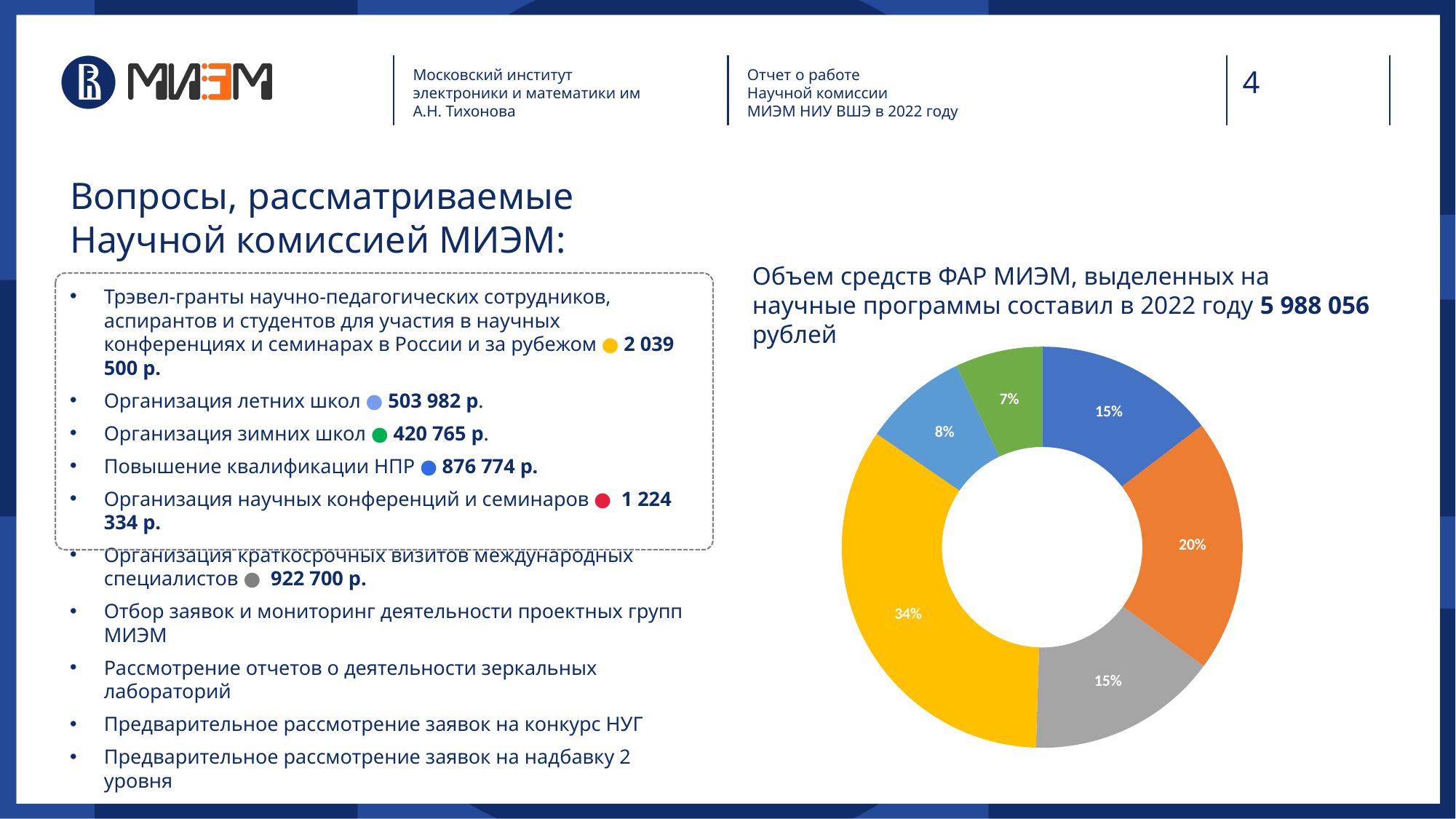
What is the largest share shown in the doughnut chart? 34% Which slice is larger in the doughnut chart, the orange one or the gray one? Orange (20%) What kind of chart is shown on the slide? Doughnut (pie) chart What percentage is shown on the yellow slice of the doughnut chart? 34% How many slices does the doughnut chart have? 6 What percentage is shown on the gray slice of the doughnut chart? 15% What is the difference in percentage points between the yellow slice and the orange slice? 14 percentage points What percentage is shown on the light blue slice of the doughnut chart? 8% What percentage is shown on the green slice of the doughnut chart? 7% According to the text above the chart, what was the total amount of ФАР МИЭМ funds allocated to research programs in 2022? 5 988 056 рублей What is the smallest share shown in the doughnut chart? 7% What percentage is shown on the orange slice of the doughnut chart? 20%